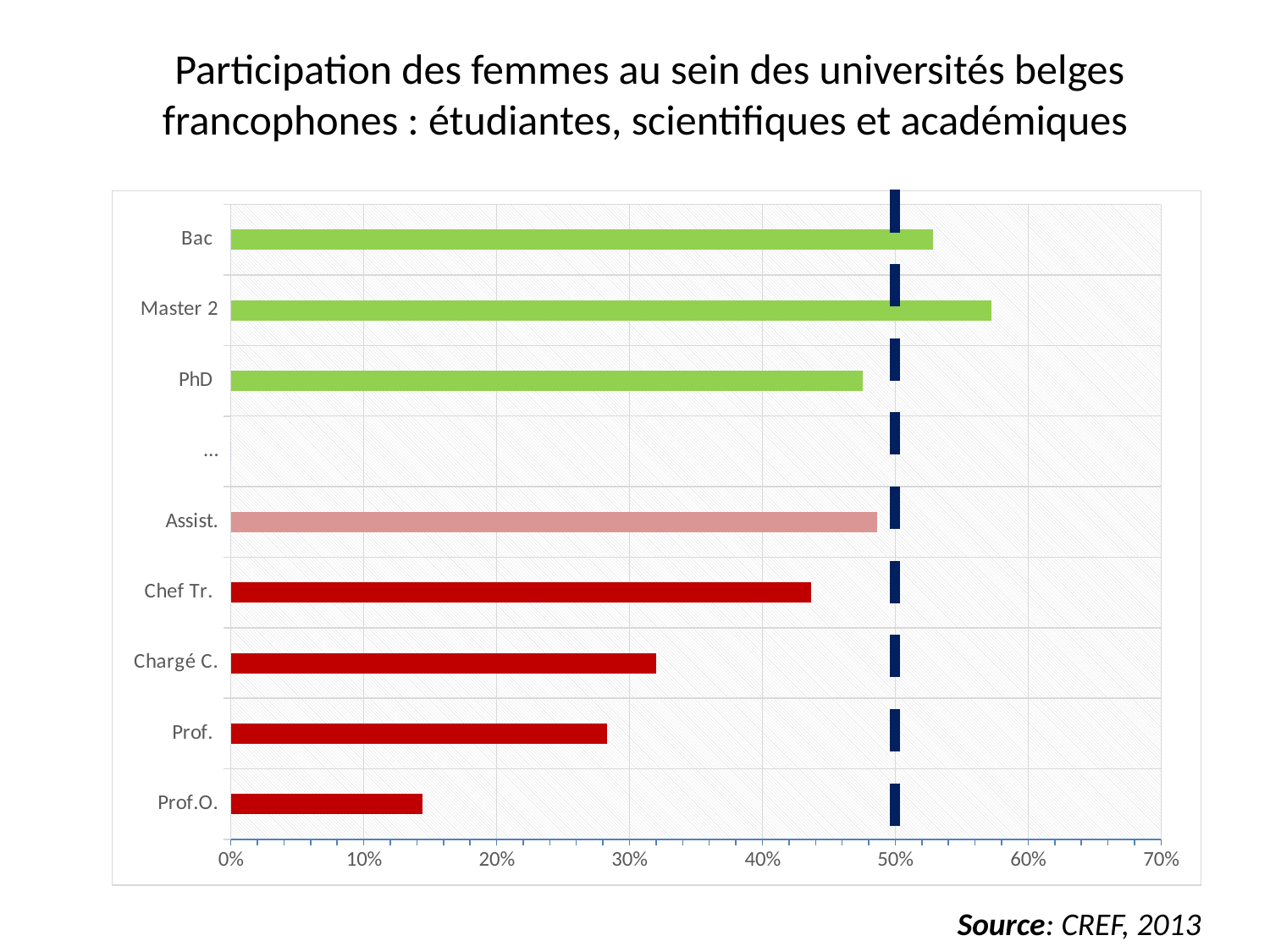
Which category has the highest value? Master 2 How many bars are plotted on the chart? 8 Is the value for Prof. greater or less than 30%? less Which is larger, the value for Master 2 or the value for Bac? Master 2 Is the value for Bac greater or less than 50%? greater Which category has the lowest value? Prof.O. Is the value for Prof.O. greater or less than 10%? greater At what percentage is the vertical dark blue reference line drawn? 50% What kind of chart is shown on the slide? bar chart Which is larger, the value for Chargé C. or the value for Chef Tr.? Chef Tr.